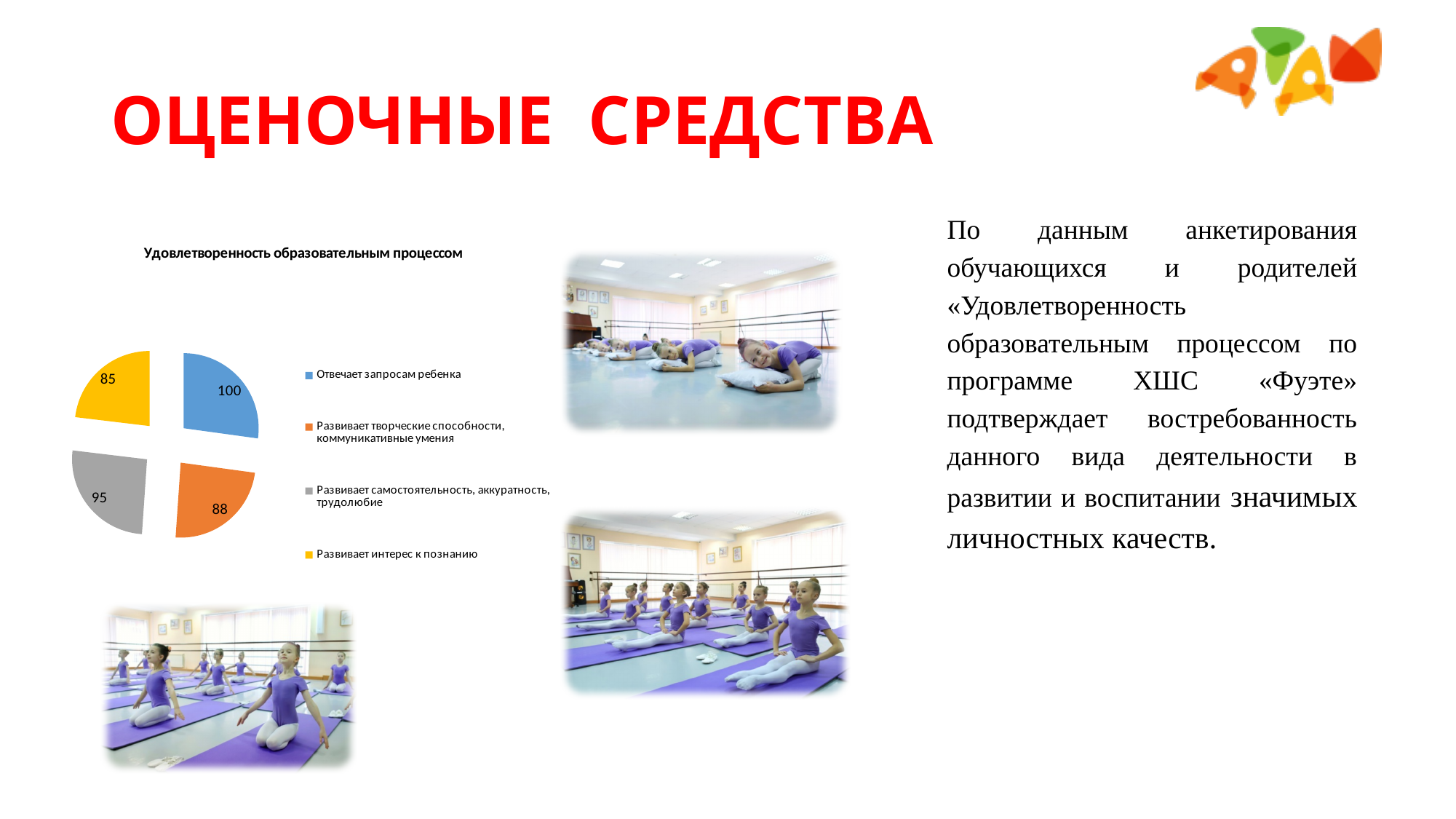
What colour is the slice for "Развивает интерес к познанию"? Yellow Which category has the lowest value in the pie chart? Развивает интерес к познанию What kind of chart is shown on the slide? Pie chart Which is larger: the value for "Развивает самостоятельность, аккуратность, трудолюбие" or for "Развивает творческие способности, коммуникативные умения"? Развивает самостоятельность, аккуратность, трудолюбие What is the title of the chart? Удовлетворенность образовательным процессом How many slices does the pie chart have? 4 What is the difference between the values for "Отвечает запросам ребенка" and "Развивает интерес к познанию"? 15 What value is shown for "Развивает творческие способности, коммуникативные умения"? 88 What value is shown for "Развивает самостоятельность, аккуратность, трудолюбие"? 95 What value is shown for "Развивает интерес к познанию"? 85 What value is shown for "Отвечает запросам ребенка"? 100 Which category has the highest value in the pie chart? Отвечает запросам ребенка